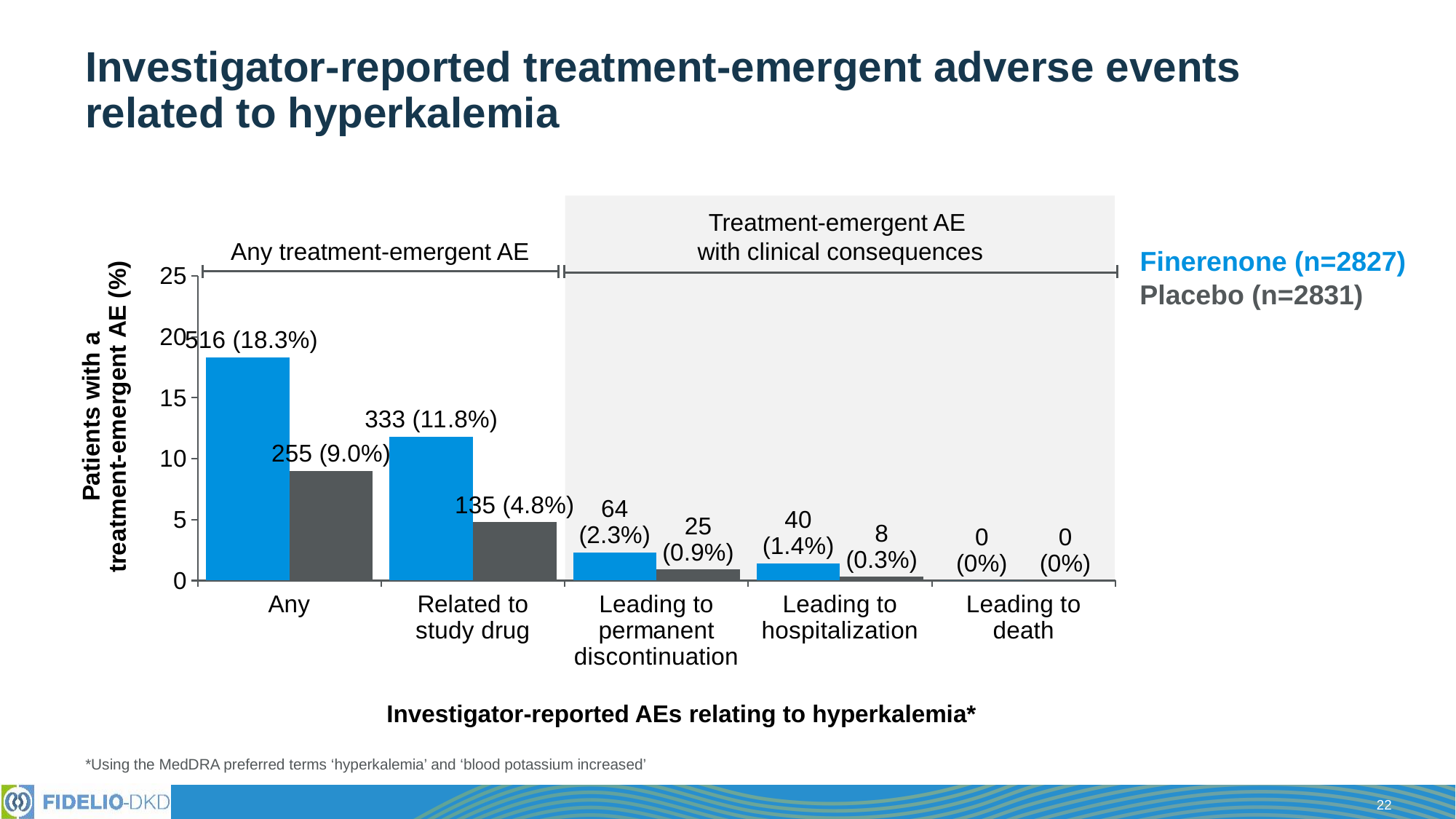
Which category has the highest value for Finerenone? Any How many series does the legend list? 2 How many Placebo patients had a treatment-emergent AE leading to permanent discontinuation? 25 What percentage of Finerenone patients had a treatment-emergent AE leading to hospitalization? 1.4% Which is larger in the 'Related to study drug' category, Finerenone or Placebo? Finerenone What is the difference in percentage points between Finerenone and Placebo in the 'Any' category? 9.3 What kind of chart is shown on the slide? Bar chart What is the data label for Finerenone in the 'Any' category? 516 (18.3%) How many categories are shown on the x axis? 5 Which category has the lowest value for Placebo? Leading to death What is the x-axis title of the chart? Investigator-reported AEs relating to hyperkalemia* What is the data label for Placebo in the 'Related to study drug' category? 135 (4.8%)